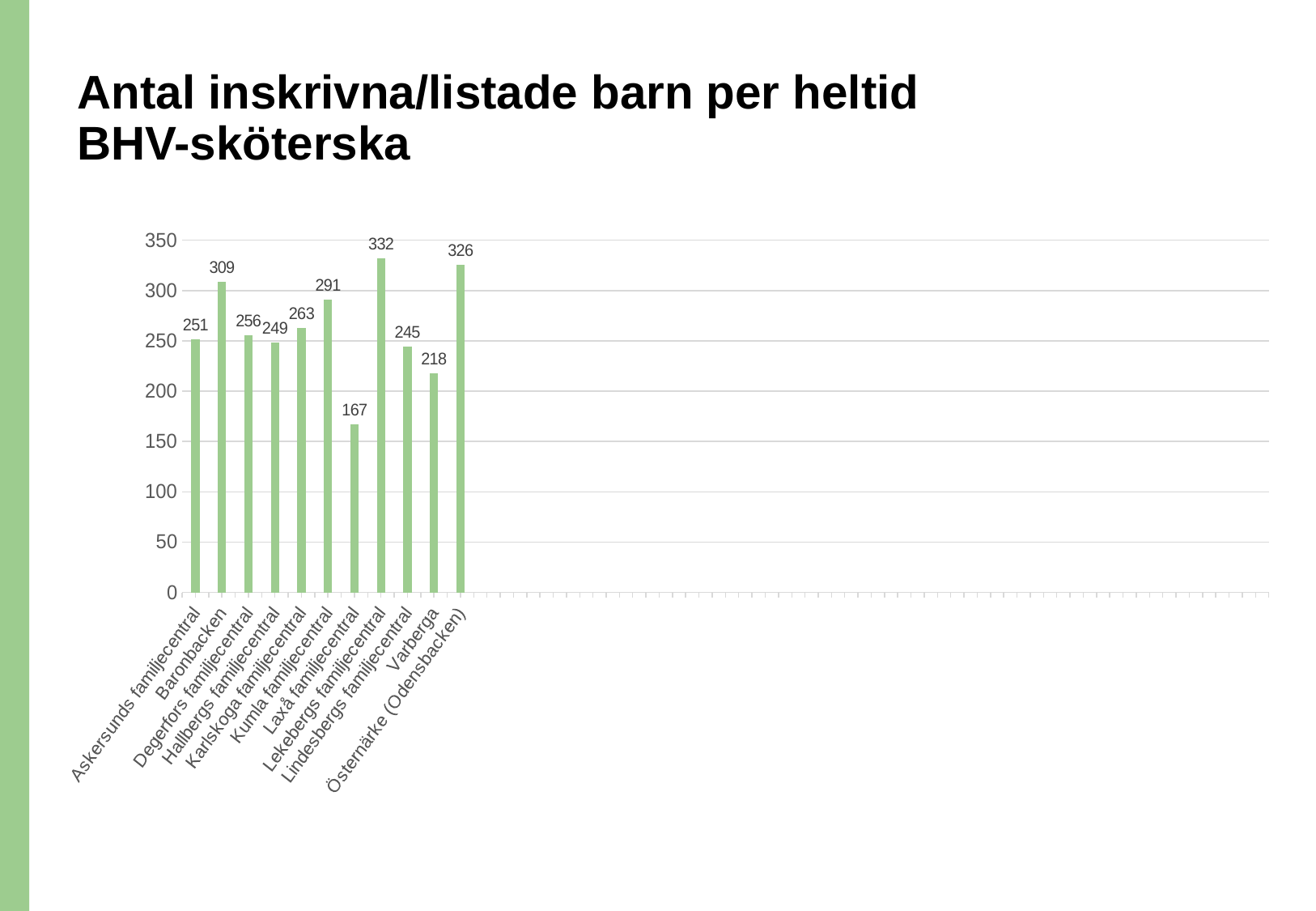
What is the difference between the values for Lekebergs familjecentral and Laxå familjecentral? 165 Which category has the highest value? Lekebergs familjecentral What is the value for Östernärke (Odensbacken)? 326 Is the value for Lindesbergs familjecentral greater or less than 200? greater What is the value for Baronbacken? 309 Which category has the lowest value? Laxå familjecentral How many categories are shown on the x axis? 11 Which is larger, the value for Kumla familjecentral or the value for Karlskoga familjecentral? Kumla familjecentral What is the value for Laxå familjecentral? 167 What kind of chart is shown on the slide? bar chart What is the title of the slide? Antal inskrivna/listade barn per heltid BHV-sköterska What is the value for Varberga? 218